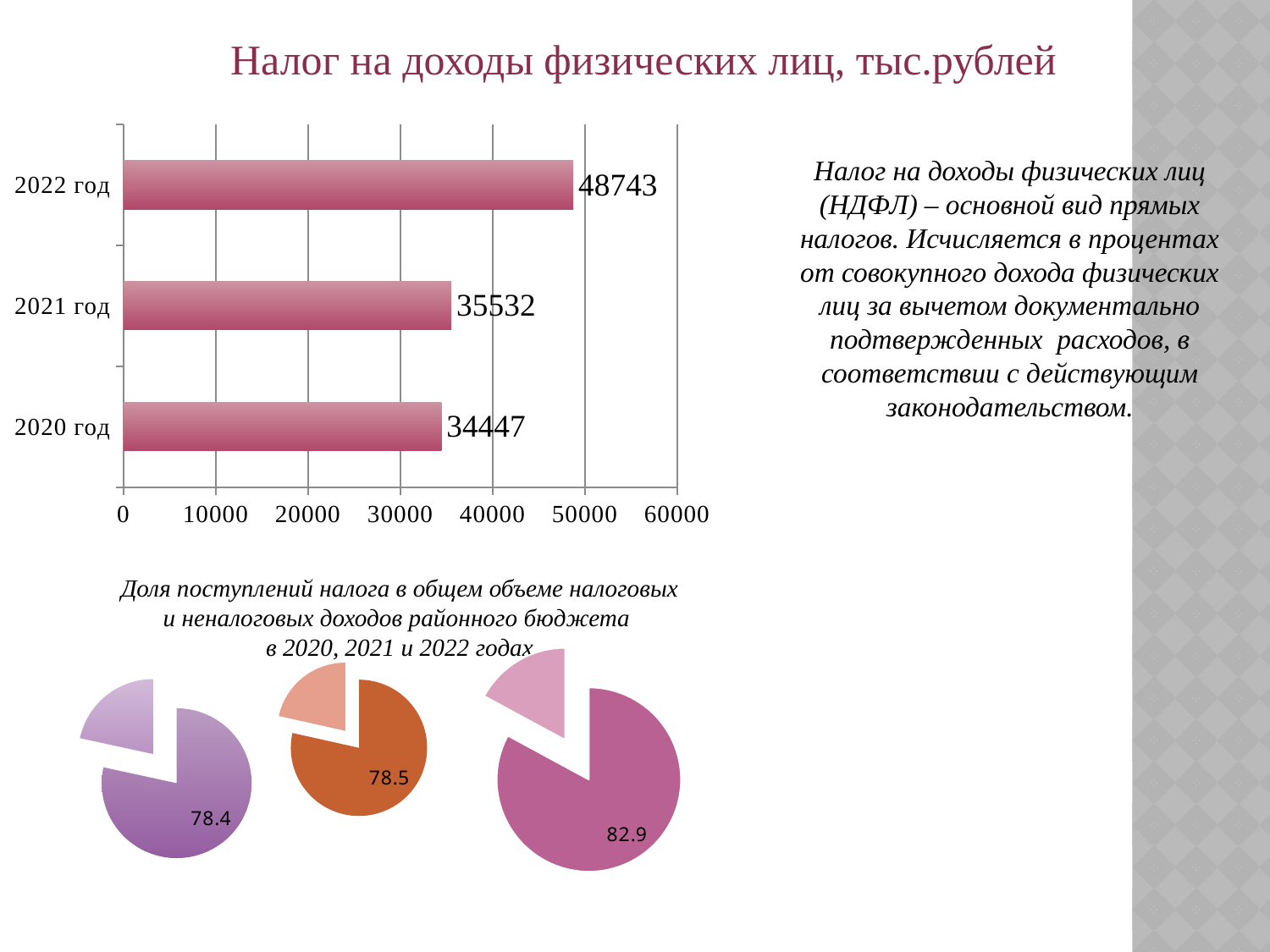
What type of chart is the chart titled 'Налог на доходы физических лиц, тыс.рублей'? Bar chart In the pie charts at the bottom of the slide, what value is labelled on the rightmost (largest) pie? 82.9 In the bar chart 'Налог на доходы физических лиц, тыс.рублей', what is the value for 2022 год? 48743 In the bar chart 'Налог на доходы физических лиц, тыс.рублей', what is the value for 2021 год? 35532 In the bar chart 'Налог на доходы физических лиц, тыс.рублей', which year has the lowest value? 2020 год In the bar chart 'Налог на доходы физических лиц, тыс.рублей', which year has the highest value? 2022 год In the bar chart 'Налог на доходы физических лиц, тыс.рублей', what is the value for 2020 год? 34447 In the bar chart 'Налог на доходы физических лиц, тыс.рублей', what is the difference between the values for 2021 год and 2020 год? 1085 In the bar chart 'Налог на доходы физических лиц, тыс.рублей', what is the difference between the values for 2022 год and 2021 год? 13211 How many bars are shown in the bar chart 'Налог на доходы физических лиц, тыс.рублей'? 3 In the pie charts at the bottom of the slide, what value is labelled on the leftmost pie? 78.4 In the bar chart 'Налог на доходы физических лиц, тыс.рублей', is the value for 2022 год greater or less than 40000? greater